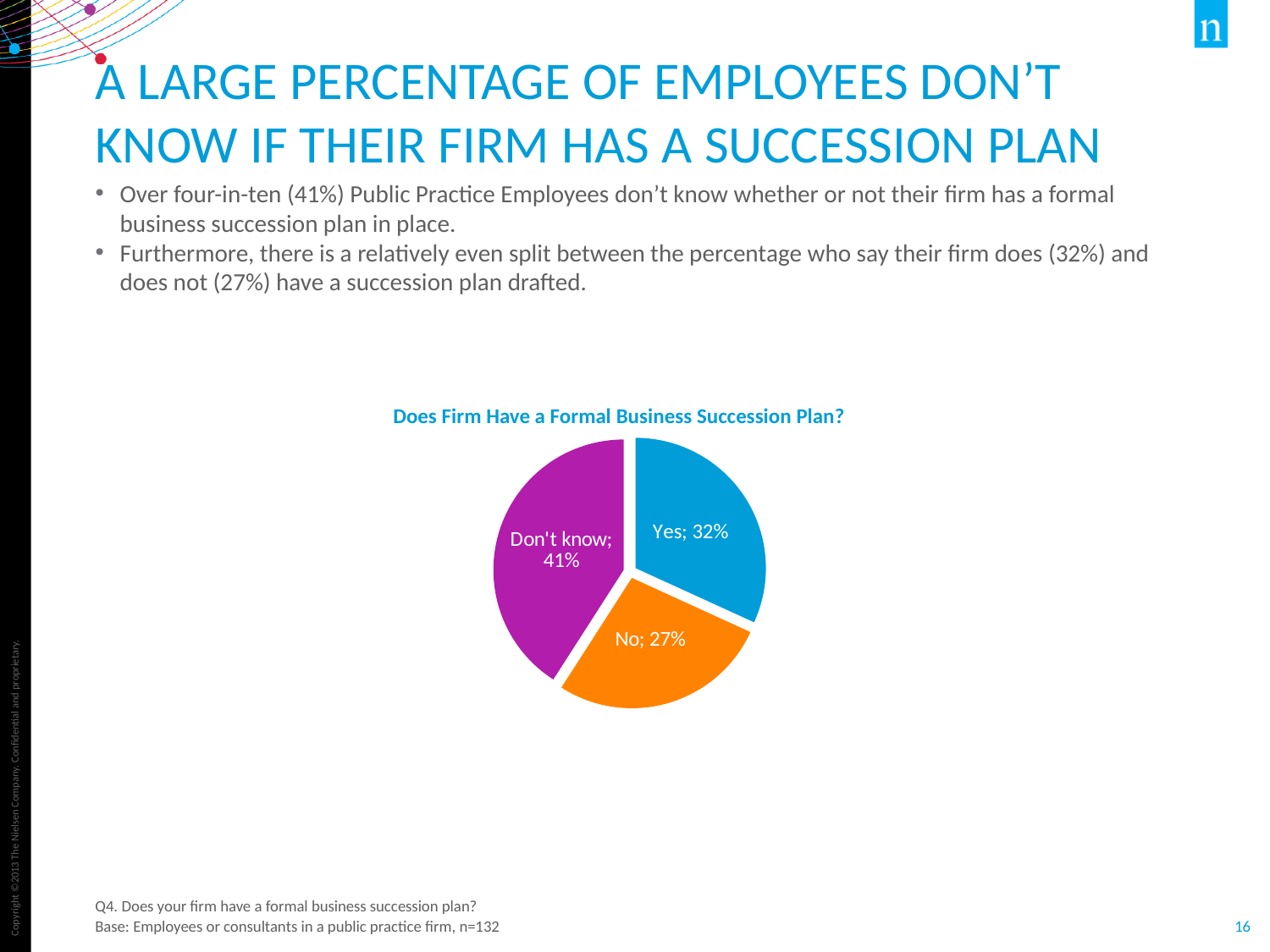
What percentage of respondents answered "Yes"? 32% Which response has the smallest share of the pie? No What is the difference in percentage points between "Yes" and "No"? 5 percentage points What is the difference in percentage points between "Don't know" and "Yes"? 9 percentage points What kind of chart is shown on the slide? Pie chart How many slices does the pie chart have? 3 What percentage of respondents answered "Don't know"? 41% What colour is the "Don't know" slice? Purple What percentage of respondents answered "No"? 27% What is the title of the chart? Does Firm Have a Formal Business Succession Plan? Which response has the largest share of the pie? Don't know Which is larger, the share for "Yes" or the share for "No"? Yes